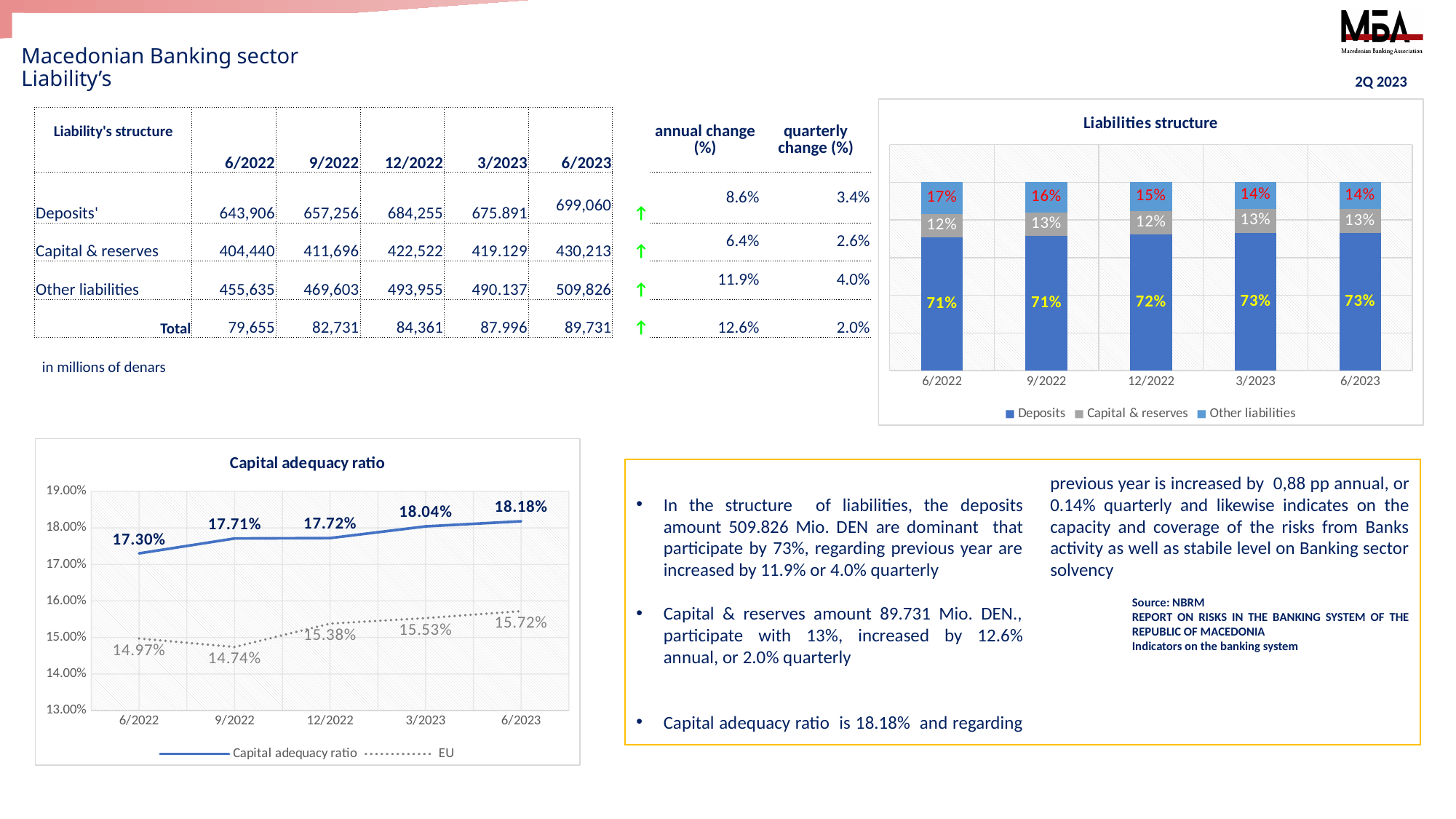
What kind of chart is the Liabilities structure chart? stacked bar chart In the Liabilities structure chart, what is the difference between the Deposits share in 6/2023 and in 6/2022? 2 percentage points In the Liabilities structure chart, how many series does the legend list? 3 In the Liabilities structure chart, what share do Other liabilities have in 6/2022? 17% In the Capital adequacy ratio chart, how many periods are plotted on the x axis? 5 In the Capital adequacy ratio chart, what is the Capital adequacy ratio value for 6/2023? 18.18% In the Capital adequacy ratio chart, which period has the lowest EU value? 9/2022 In the Liabilities structure chart, what share do Deposits have in 6/2023? 73% In the Liabilities structure chart, does the share of Other liabilities rise or fall from 6/2022 to 6/2023? fall In the Liabilities structure chart, what share do Capital & reserves have in 9/2022? 13% In the Capital adequacy ratio chart, what is the difference between the Capital adequacy ratio and the EU value in 6/2023? 2.46 percentage points In the Capital adequacy ratio chart, what is the EU value for 9/2022? 14.74%